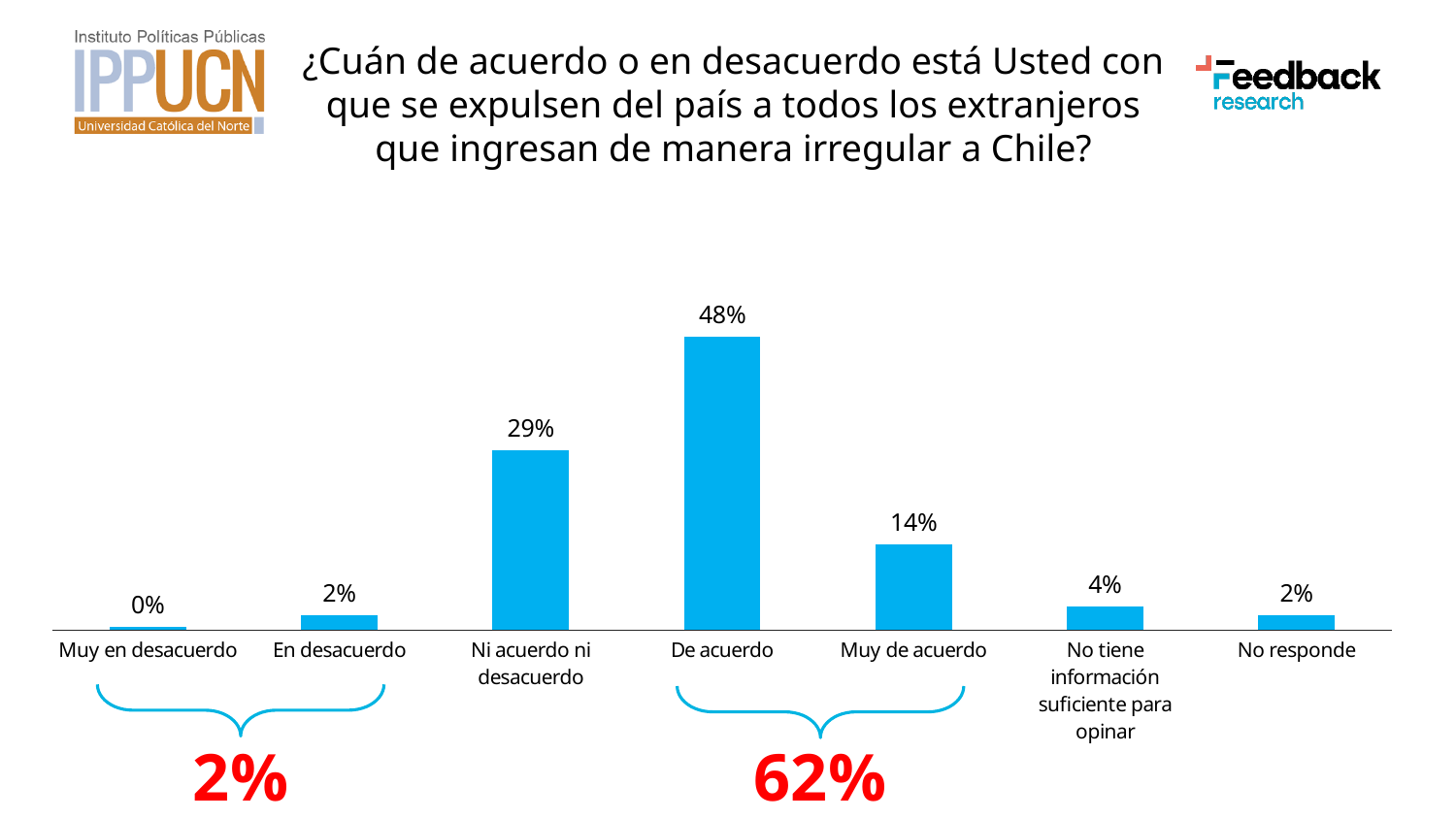
What percentage of respondents answered "De acuerdo"? 48% Which response category has the lowest percentage? Muy en desacuerdo What percentage of respondents answered "No tiene información suficiente para opinar"? 4% What combined percentage is shown in red under the bracket grouping "De acuerdo" and "Muy de acuerdo"? 62% What percentage of respondents answered "Ni acuerdo ni desacuerdo"? 29% What type of chart is shown on the slide? Bar chart How many response categories are shown on the chart? 7 What is the difference in percentage points between "De acuerdo" and "Ni acuerdo ni desacuerdo"? 19 Which is larger, the value for "Muy de acuerdo" or the value for "No responde"? Muy de acuerdo What percentage of respondents answered "Muy de acuerdo"? 14% What combined percentage is shown in red under the bracket grouping "Muy en desacuerdo" and "En desacuerdo"? 2% Which response category has the highest percentage? De acuerdo